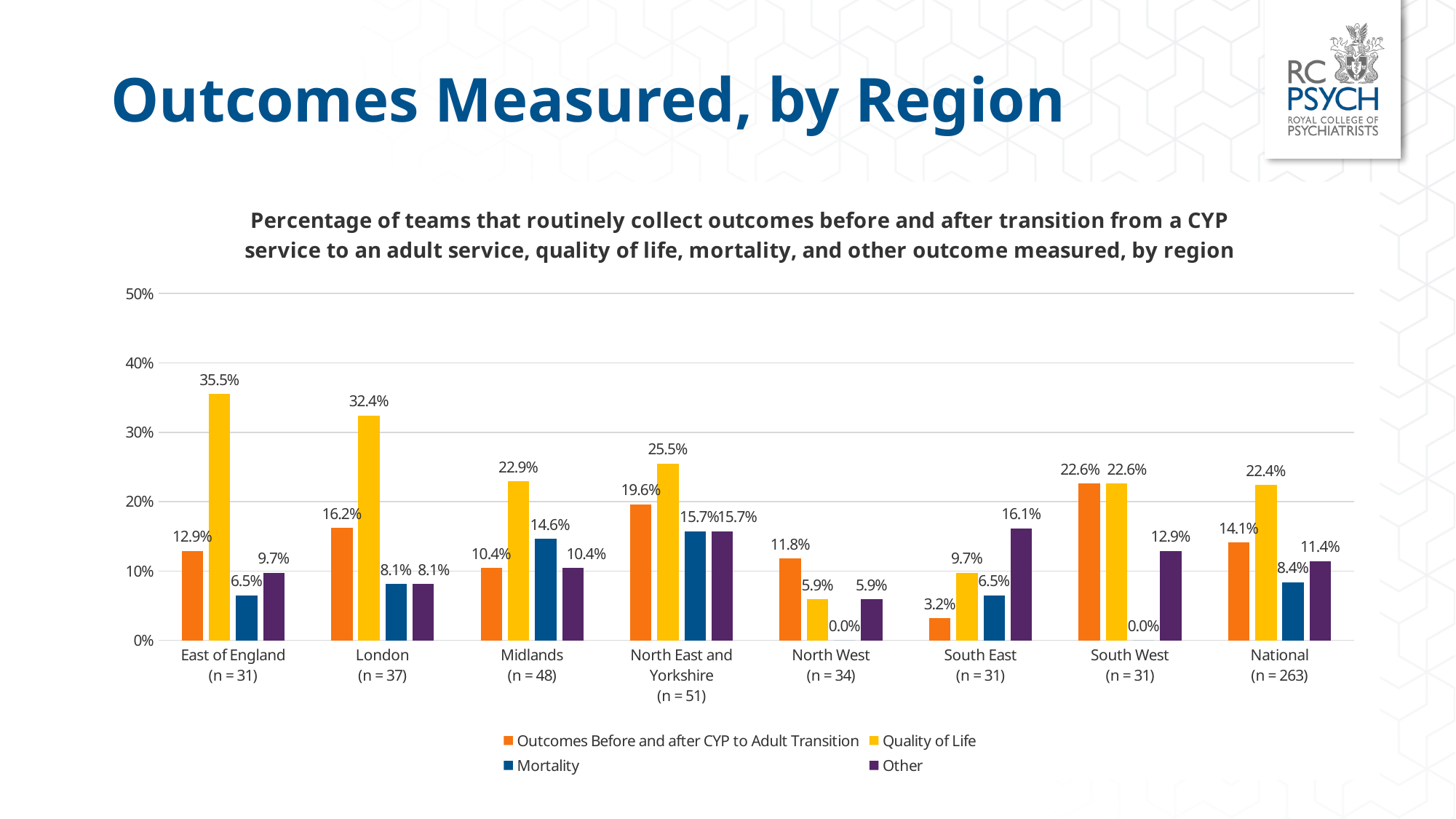
What is the difference between the Quality of Life values for East of England and London? 3.1% What type of chart is shown on the slide? Bar chart What is the National value for Outcomes Before and after CYP to Adult Transition? 14.1% What is the Quality of Life value for East of England? 35.5% How many series does the legend list? 4 What is the Mortality value for Midlands? 14.6% What is the Other value for South East? 16.1% Which region has the lowest value for Outcomes Before and after CYP to Adult Transition? South East Which regions have a Mortality value of 0.0%? North West and South West How many regions (categories) are shown on the x axis? 8 Which region has the highest Quality of Life value? East of England Which is larger for North West: the Outcomes Before and after CYP to Adult Transition value or the Quality of Life value? Outcomes Before and after CYP to Adult Transition